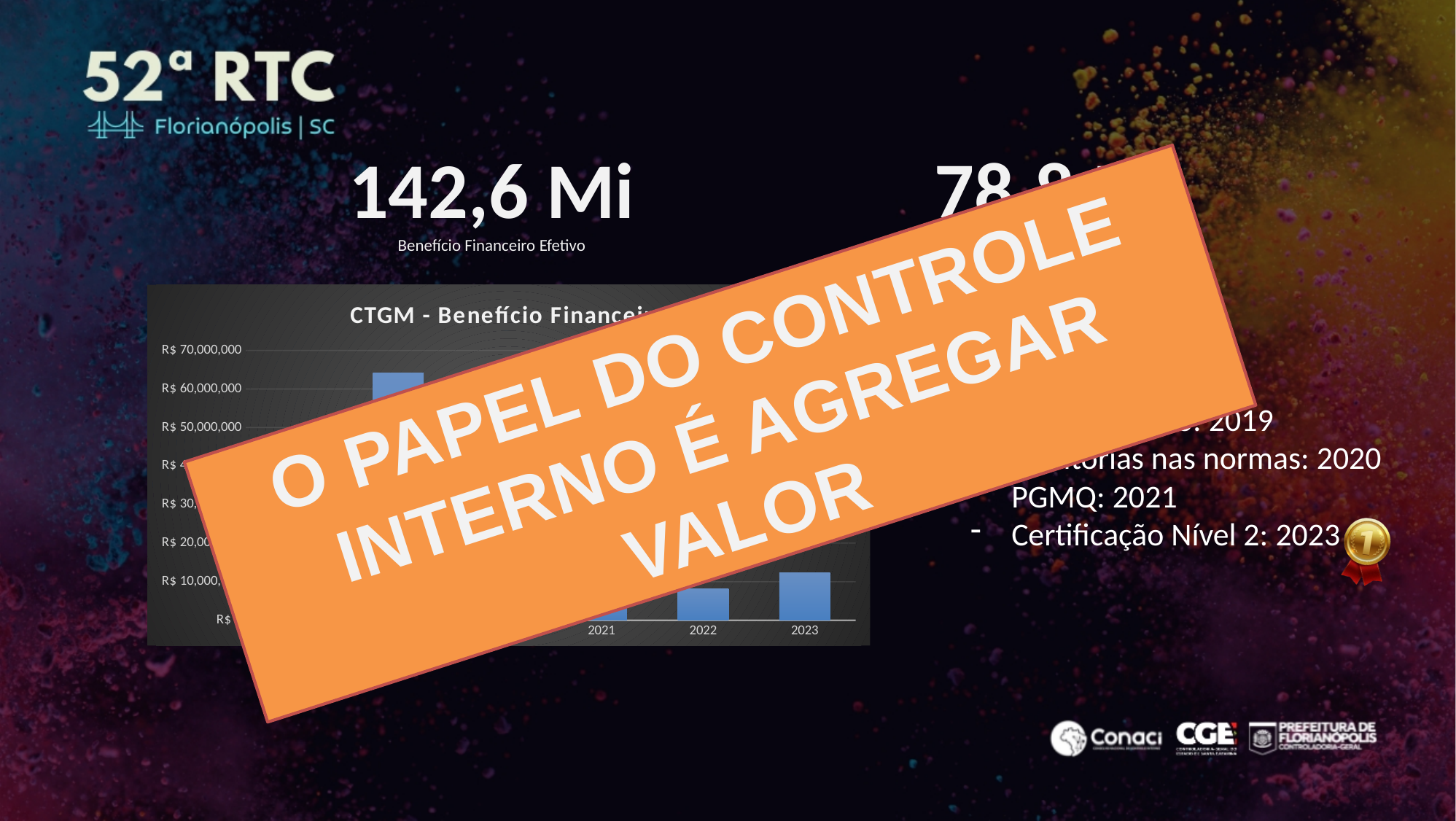
What kind of chart is shown on the slide? bar chart Which of 2022 and 2023 has the larger value in the bar chart? 2023 Is the value for 2023 in the bar chart greater or less than R$ 10,000,000? greater Does the value rise or fall from 2022 to 2023 in the bar chart? rise What is the rightmost category label on the x axis of the bar chart? 2023 Is the value for 2022 in the bar chart greater or less than R$ 20,000,000? less What is the highest tick value shown on the y axis of the bar chart? R$ 70,000,000 Is the value for 2023 in the bar chart greater or less than R$ 20,000,000? less